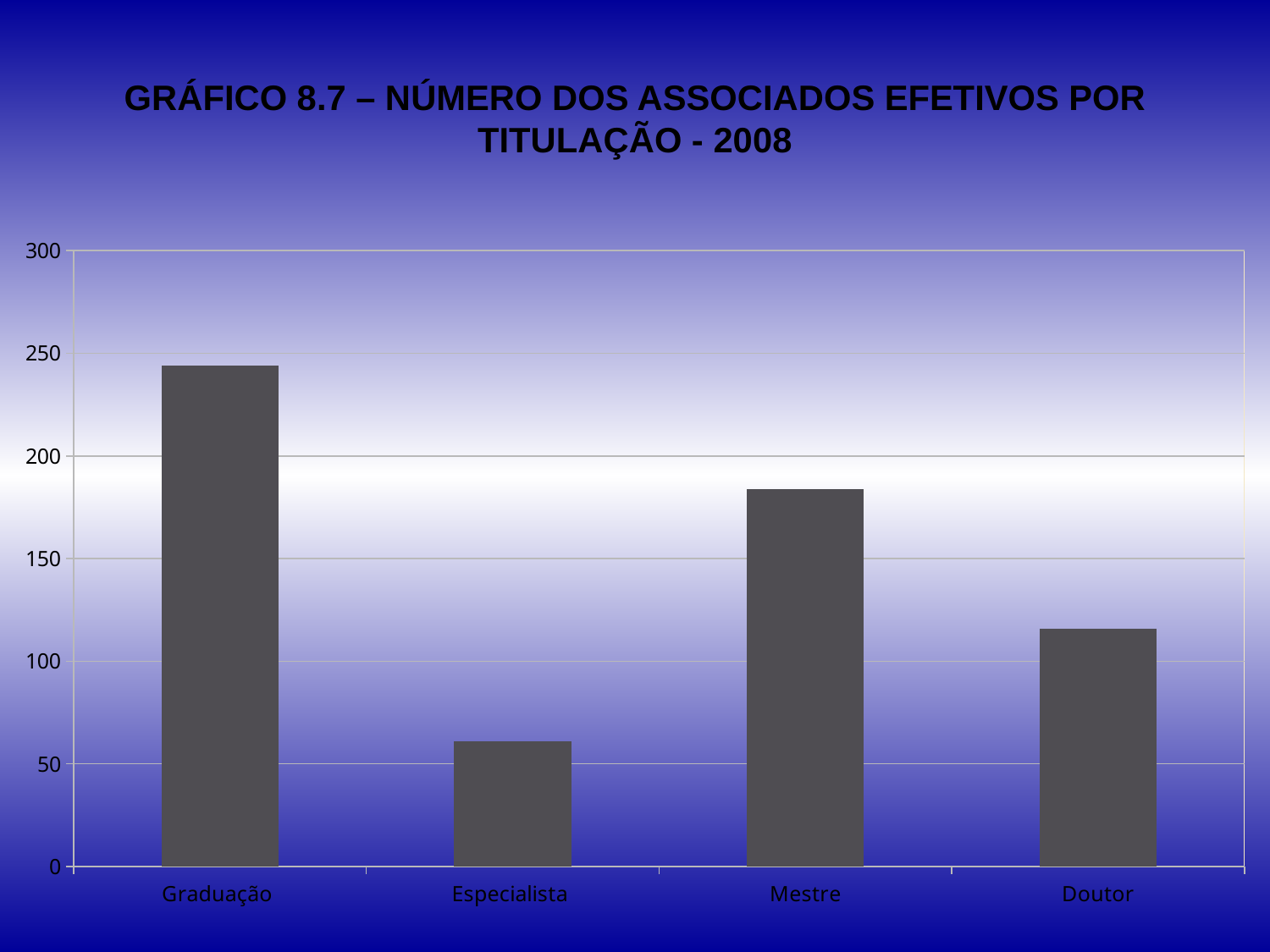
Is the value for Doutor greater or less than 150? less What kind of chart is shown on the slide? bar chart What is the title of the chart? GRÁFICO 8.7 – NÚMERO DOS ASSOCIADOS EFETIVOS POR TITULAÇÃO - 2008 How many categories are shown on the x axis of the chart? 4 Which is larger, the value for Mestre or the value for Doutor? Mestre Is the value for Especialista greater or less than 100? less What is the maximum value shown on the y axis? 300 Which category has the lowest value? Especialista Which category has the highest value? Graduação Is the value for Mestre greater or less than 150? greater Which is larger, the value for Especialista or the value for Doutor? Doutor